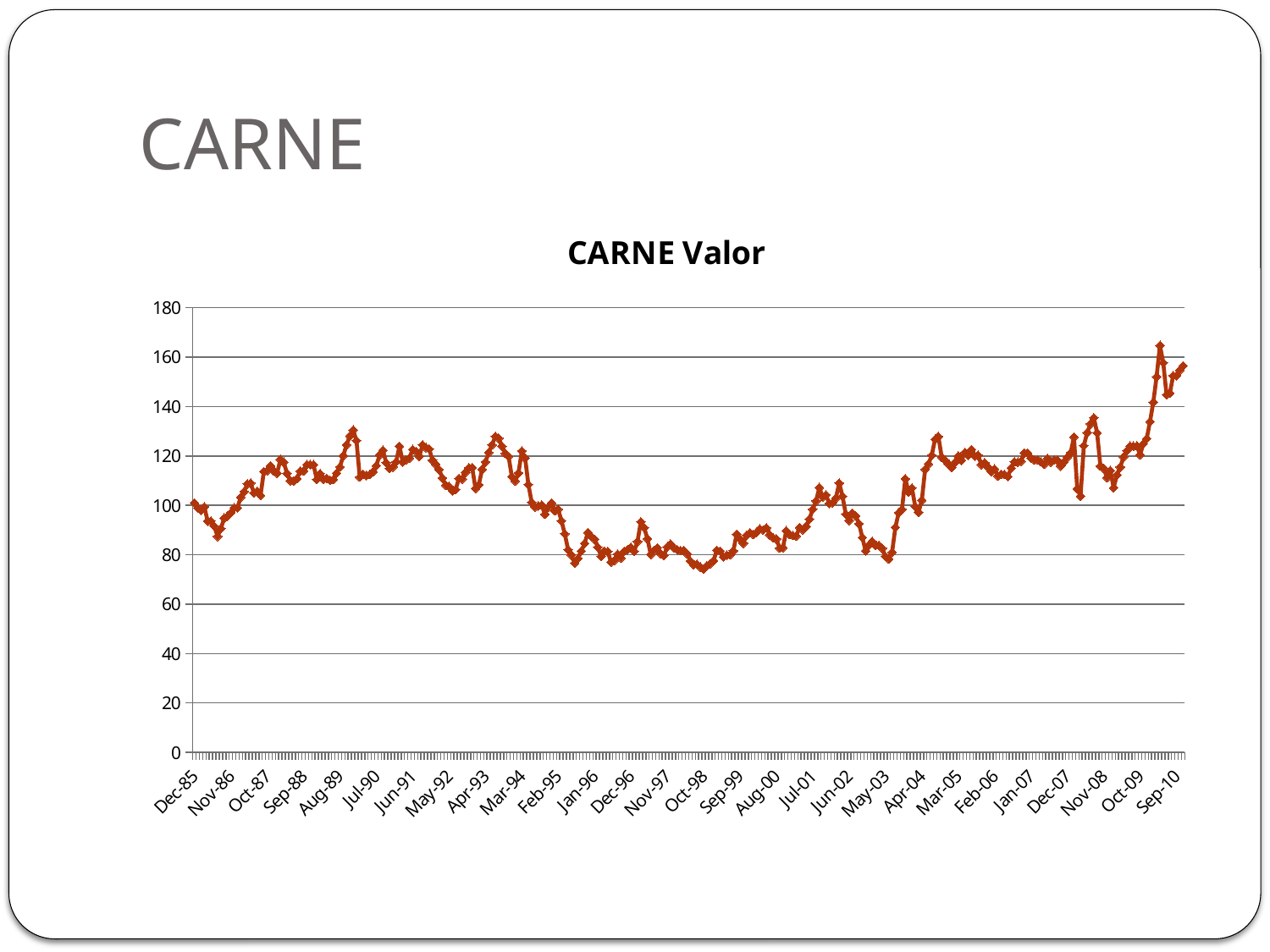
Is the value at Nov-08 greater or less than 140? less Near which x-axis label does the line reach its lowest point? Oct-98 Is the value at Jul-90 greater or less than 100? greater Is the value at Sep-10 greater or less than 140? greater Does the line generally rise or fall between Oct-98 and Sep-10? rise Near which x-axis label does the line reach its highest point? Sep-10 How many data series (lines) are plotted in the chart? 1 What kind of chart is shown on the slide? line chart What is the title of the chart? CARNE Valor